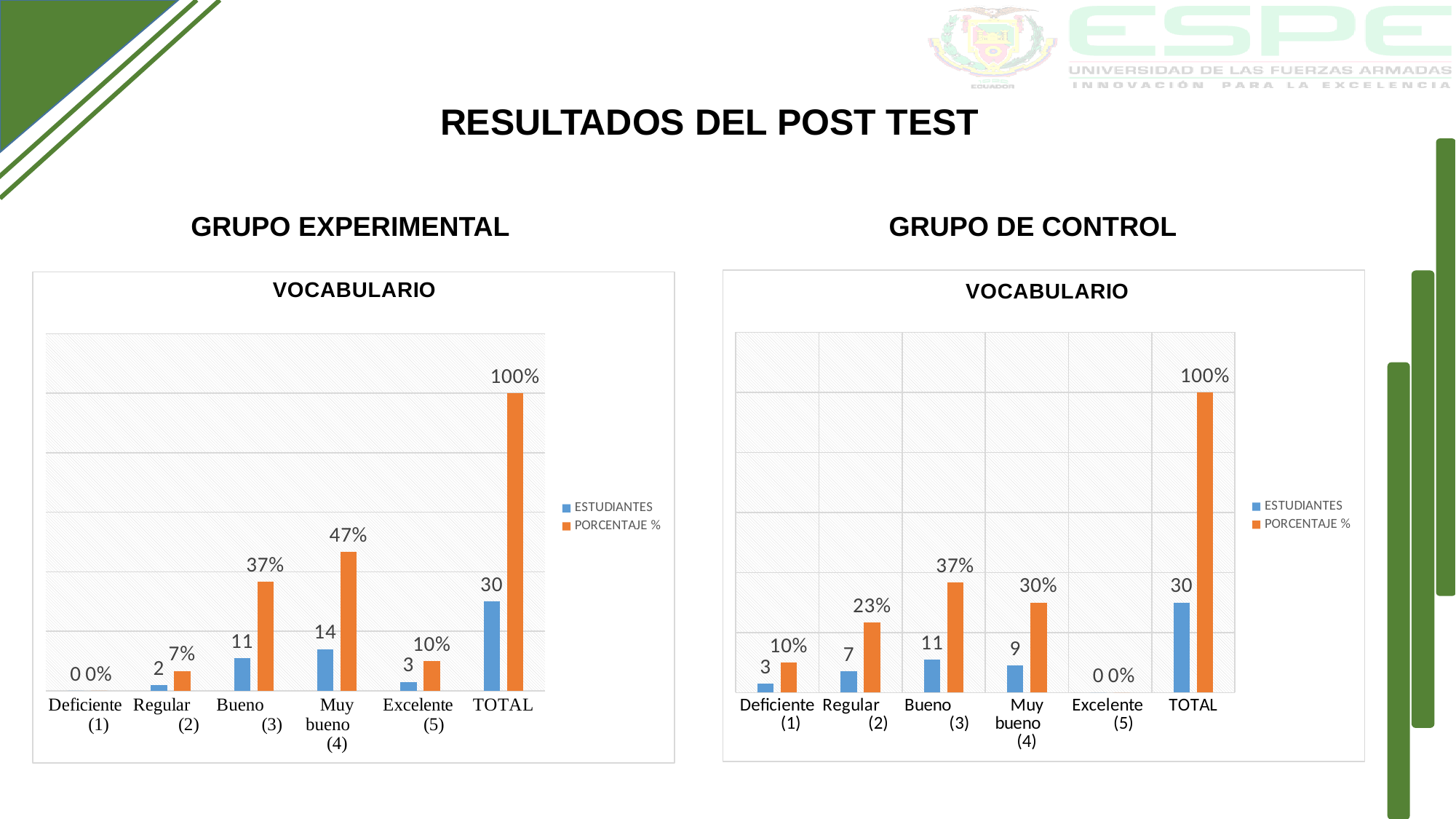
In the GRUPO DE CONTROL chart on the right, how many ESTUDIANTES are in the Regular (2) category? 7 In the GRUPO DE CONTROL chart on the right, excluding TOTAL, which category has the lowest number of ESTUDIANTES? Excelente (5) What type of chart is the GRUPO DE CONTROL chart on the right? Bar chart In the GRUPO EXPERIMENTAL chart on the left, what is the PORCENTAJE % for Bueno (3)? 37% In the GRUPO DE CONTROL chart on the right, what is the PORCENTAJE % for Muy bueno (4)? 30% In the GRUPO EXPERIMENTAL chart on the left, excluding TOTAL, which category has the highest number of ESTUDIANTES? Muy bueno (4) In the GRUPO DE CONTROL chart on the right, what is the difference in PORCENTAJE % between Bueno (3) and Regular (2)? 14% How many series does the legend of the GRUPO EXPERIMENTAL chart on the left list? 2 In the GRUPO EXPERIMENTAL chart on the left, how many ESTUDIANTES are in the Muy bueno (4) category? 14 Which chart has more ESTUDIANTES in the Deficiente (1) category, GRUPO EXPERIMENTAL or GRUPO DE CONTROL? GRUPO DE CONTROL In the GRUPO EXPERIMENTAL chart on the left, what is the difference in ESTUDIANTES between Muy bueno (4) and Bueno (3)? 3 How many categories are shown on the x axis of the GRUPO DE CONTROL chart on the right? 6